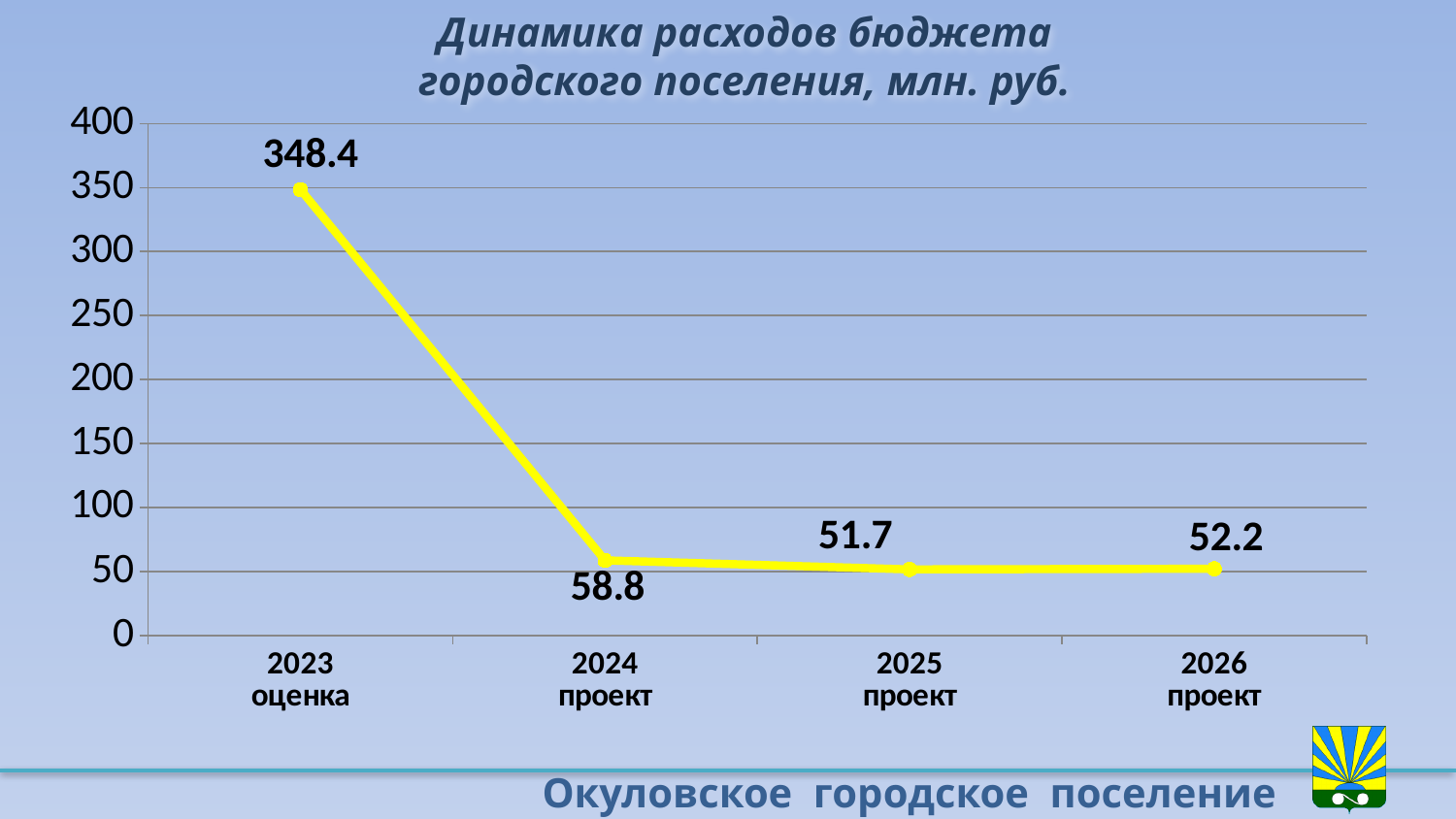
How many data points are plotted on the chart? 4 What is the value for 2024 проект? 58.8 What is the difference between the values for 2023 оценка and 2024 проект? 289.6 What is the value for 2023 оценка? 348.4 What is the value for 2026 проект? 52.2 What is the title of the chart? Динамика расходов бюджета городского поселения, млн. руб. Is the value for 2023 оценка greater or less than 300? greater Which year has the lowest value? 2025 проект Which is larger, the value for 2024 проект or 2026 проект? 2024 проект What kind of chart is shown on the slide? line chart What is the value for 2025 проект? 51.7 Which year has the highest value? 2023 оценка